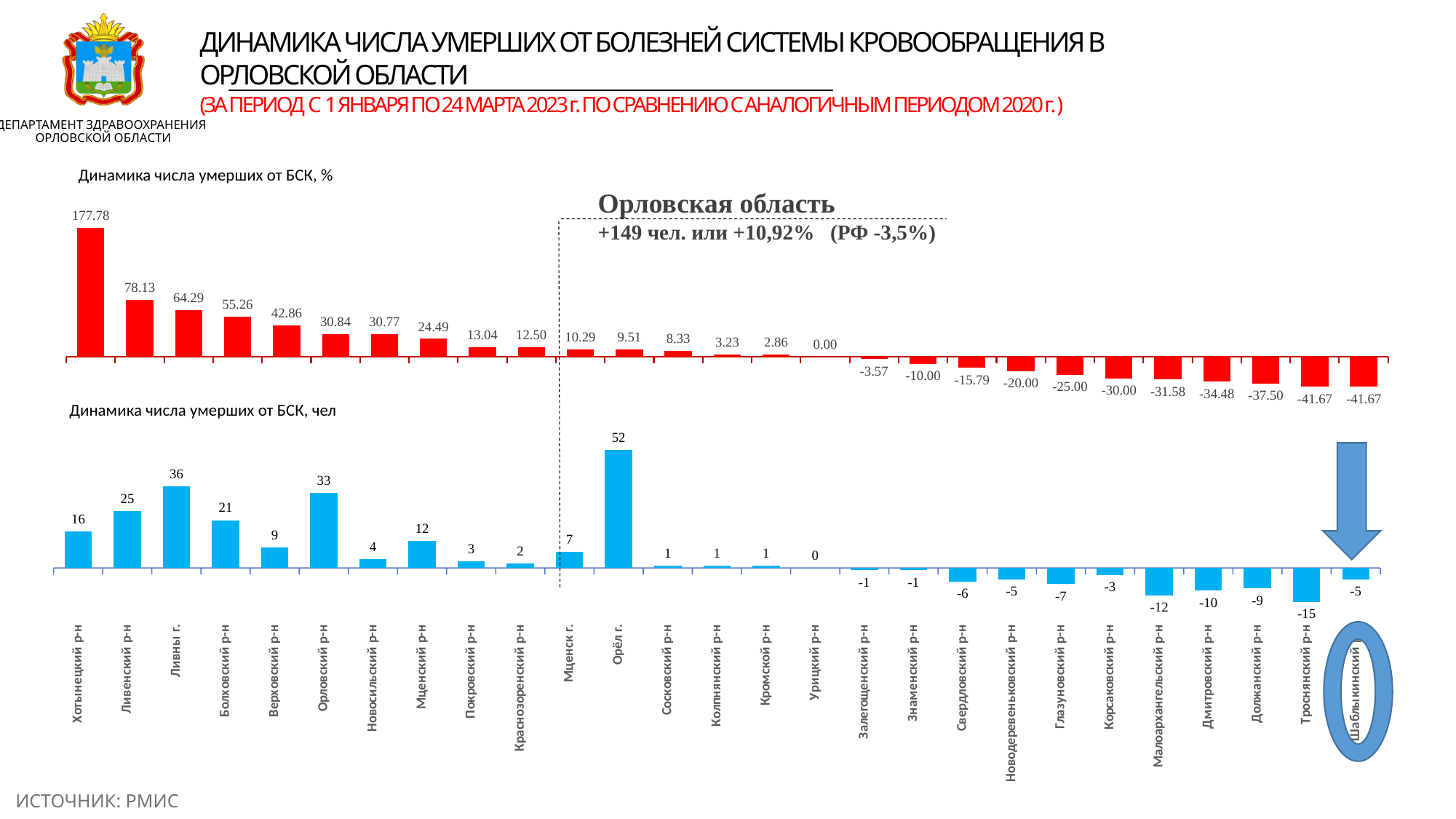
In the bottom chart (Динамика числа умерших от БСК, чел), which is larger: the value for Ливенский р-н or the value for Болховский р-н? Ливенский р-н In the bottom chart (Динамика числа умерших от БСК, чел), what is the value for Орёл г.? 52 In the bottom chart (Динамика числа умерших от БСК, чел), what is the value for Малоархангельский р-н? -12 In the top chart (Динамика числа умерших от БСК, %), do the values rise or fall from left to right along the x axis? Fall In the bottom chart (Динамика числа умерших от БСК, чел), which category has the highest value? Орёл г. In the bottom chart (Динамика числа умерших от БСК, чел), which category has the lowest value? Троснянский р-н In the top chart (Динамика числа умерших от БСК, %), which category has the highest value? Хотынецкий р-н In the bottom chart (Динамика числа умерших от БСК, чел), what is the difference between the values for Ливны г. and Орловский р-н? 3 In the top chart (Динамика числа умерших от БСК, %), what is the value for Хотынецкий р-н? 177.78 How many categories are shown on the x axis of the bottom chart (Динамика числа умерших от БСК, чел)? 27 What type of chart is the top chart (Динамика числа умерших от БСК, %)? Bar chart In the top chart (Динамика числа умерших от БСК, %), what is the value for Свердловский р-н? -15.79